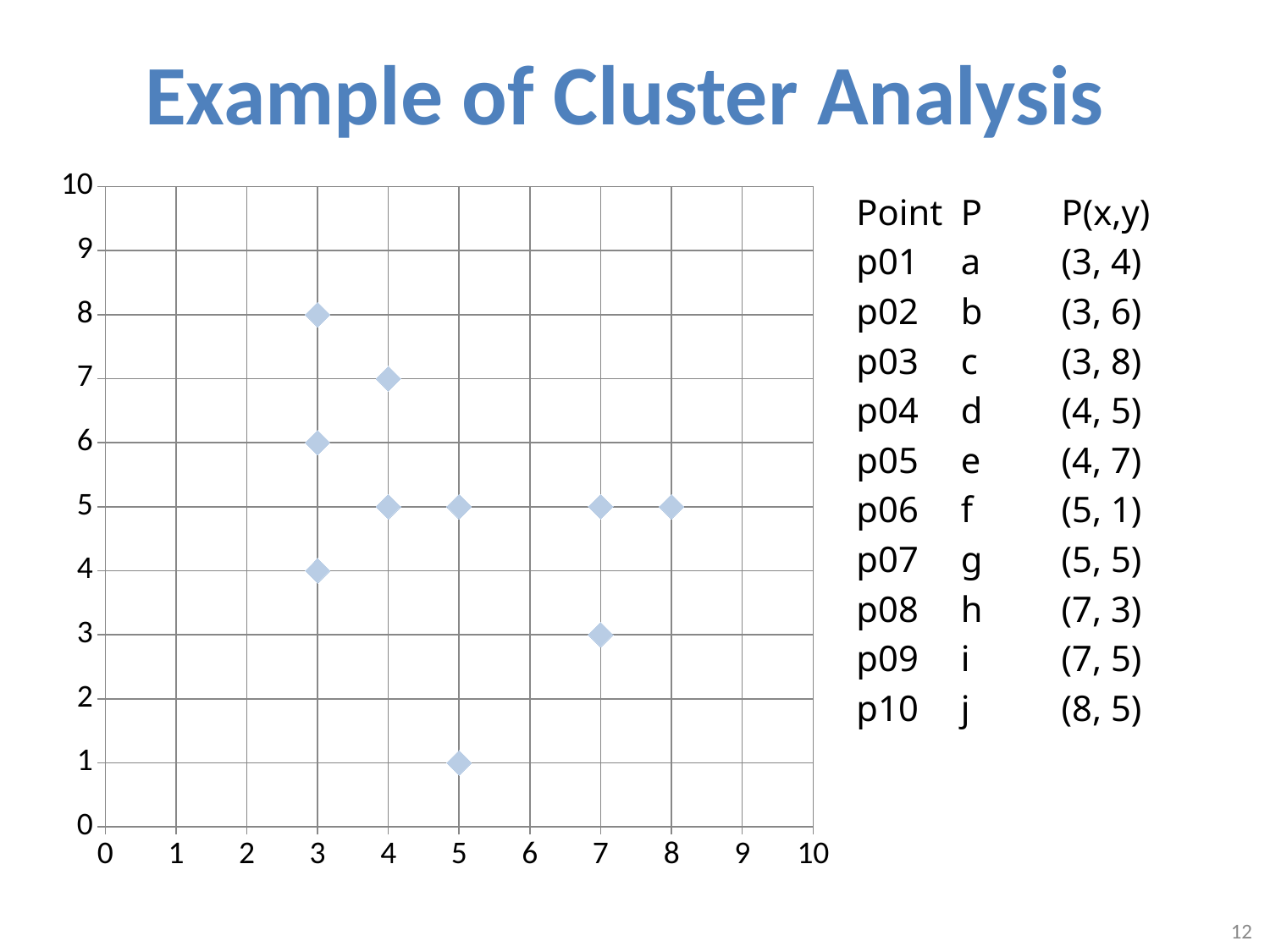
What are the coordinates of point c (p03)? (3, 8) What is the maximum value shown on the y axis? 10 What kind of chart is shown on the slide? scatter chart Is the y value of point f (p06) greater or less than 2? less Which point has the highest y value? c (p03) Which point has the larger y value, d (p04) or e (p05)? e (p05) Which point has the lowest y value? f (p06) Which point has the largest x value? j (p10) What is the x coordinate of point h (p08)? 7 How many data points are plotted on the chart? 10 What is the difference in y value between point c (p03) and point a (p01)? 4 How many points lie on the line y = 5? 4